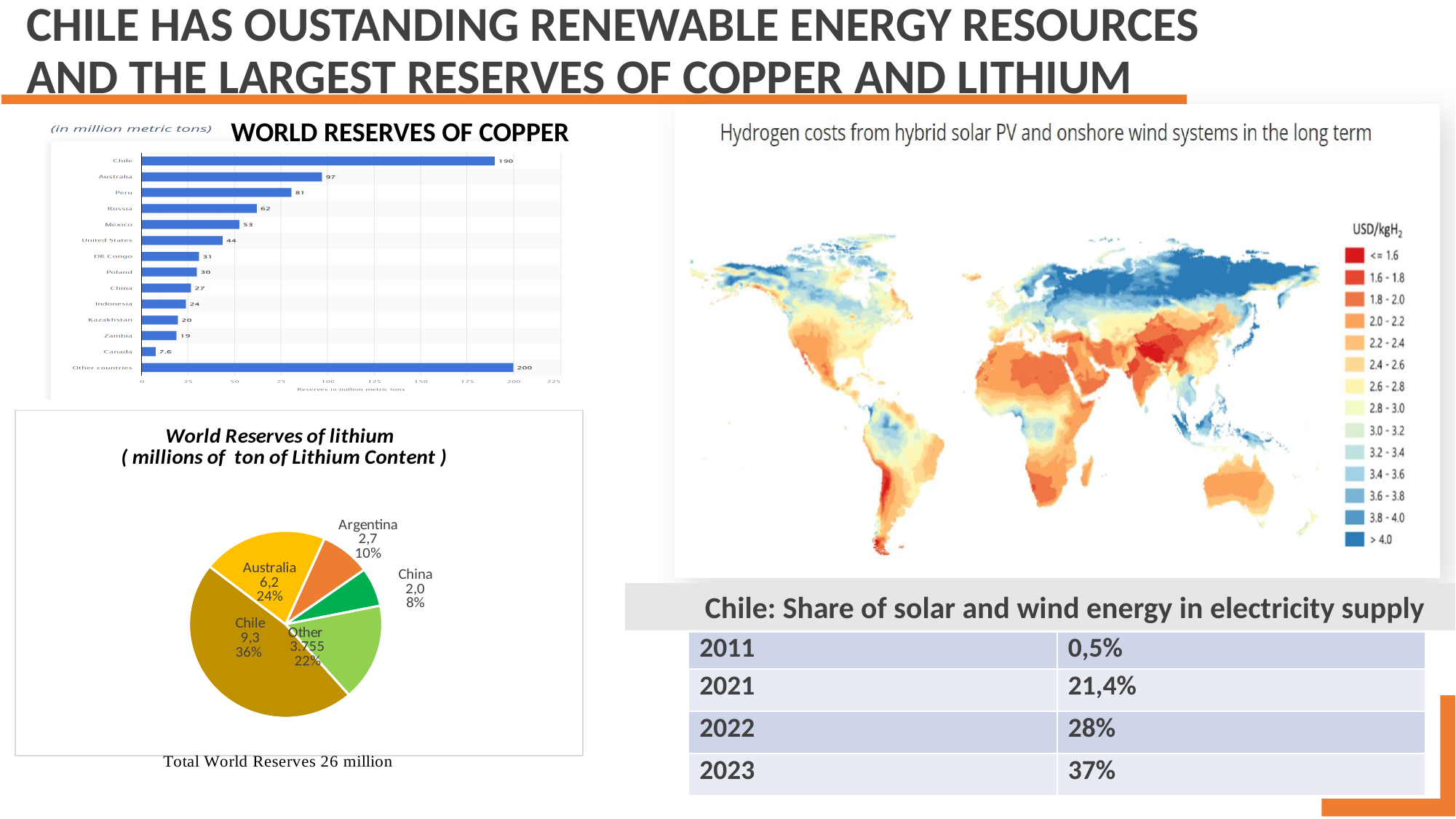
In the World Reserves of Copper chart, what is the difference between the values for Chile and Australia? 93 In the World Reserves of Copper chart, what is the value for Peru? 81 In the World Reserves of Copper chart, which category has the lowest value? Canada In the World Reserves of lithium pie chart, which slice is the smallest? China In the World Reserves of Copper chart, what is the value for Chile? 190 How many bars are shown in the World Reserves of Copper chart? 14 In the World Reserves of lithium pie chart, what percentage share does Australia have? 24% In the World Reserves of Copper chart, which is larger, the value for Russia or the value for Mexico? Russia In the World Reserves of Copper chart, which category has the longest bar? Other countries How many slices does the World Reserves of lithium pie chart have? 5 In the World Reserves of lithium pie chart, what is the value shown for Chile? 9,3 What kind of chart is the World Reserves of Copper chart? Bar chart